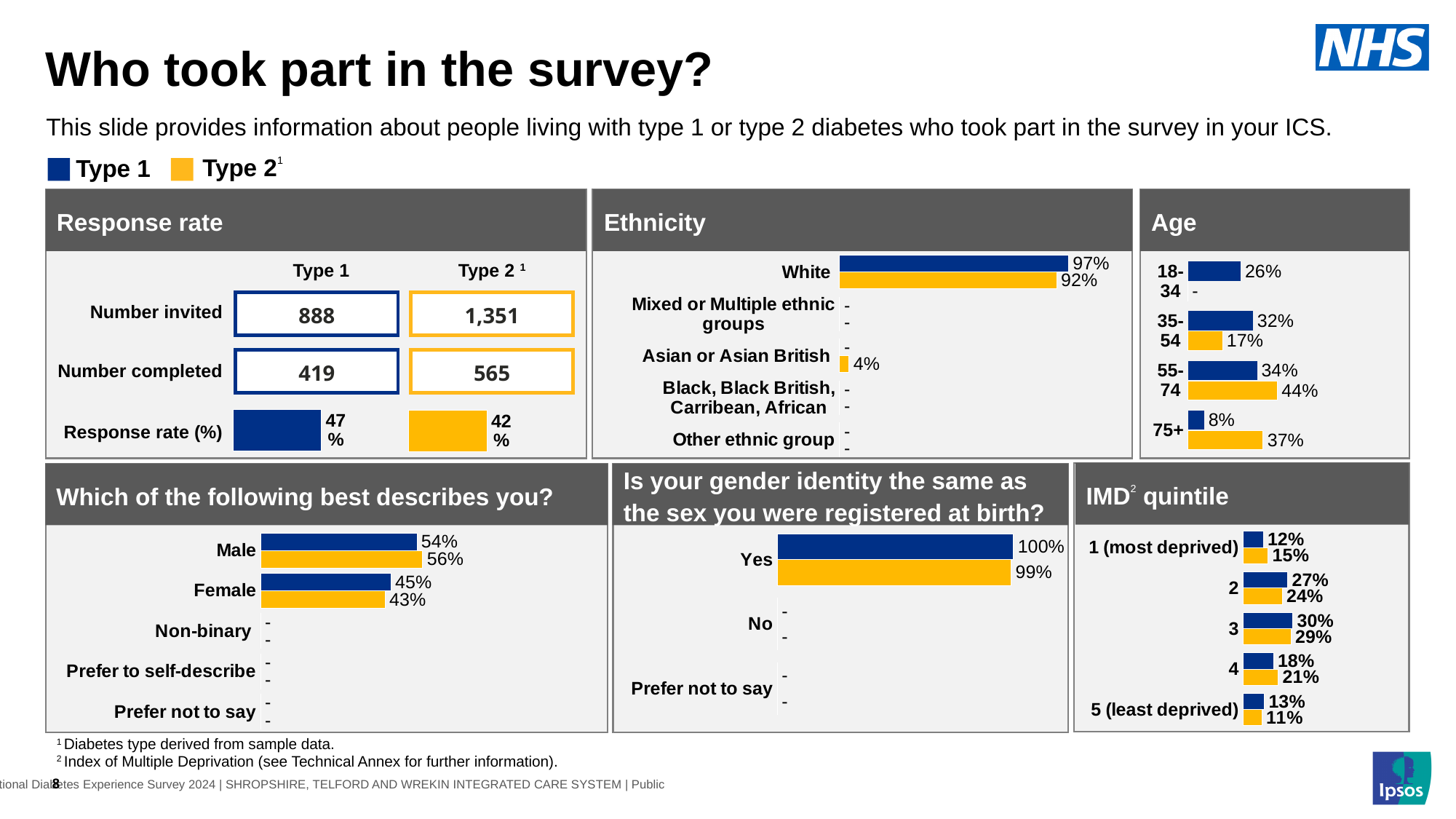
In the Age chart, which age group has the lowest Type 1 percentage? 75+ In the Age chart, which age group has the highest Type 2 percentage? 55-74 In the Ethnicity chart, what percentage of Type 1 respondents are White? 97% In the Response rate chart, what is the response rate for Type 1? 47% In the Age chart, what percentage of Type 2 respondents are aged 75+? 37% In the 'Which of the following best describes you?' chart, what percentage of Type 1 respondents are Female? 45% In the gender identity chart, what percentage of Type 2 respondents answered Yes? 99% In the Age chart, what is the difference between the Type 2 and Type 1 percentages for the 55-74 age group? 10 percentage points In the IMD quintile chart, which quintile has the highest Type 1 percentage? 3 In the 'Which of the following best describes you?' chart, is the Type 2 percentage for Male larger or smaller than the Type 1 percentage for Male? larger In the Ethnicity chart, what percentage of Type 2 respondents are Asian or Asian British? 4% In the IMD quintile chart, what is the difference between the Type 2 and Type 1 percentages for quintile 1 (most deprived)? 3 percentage points